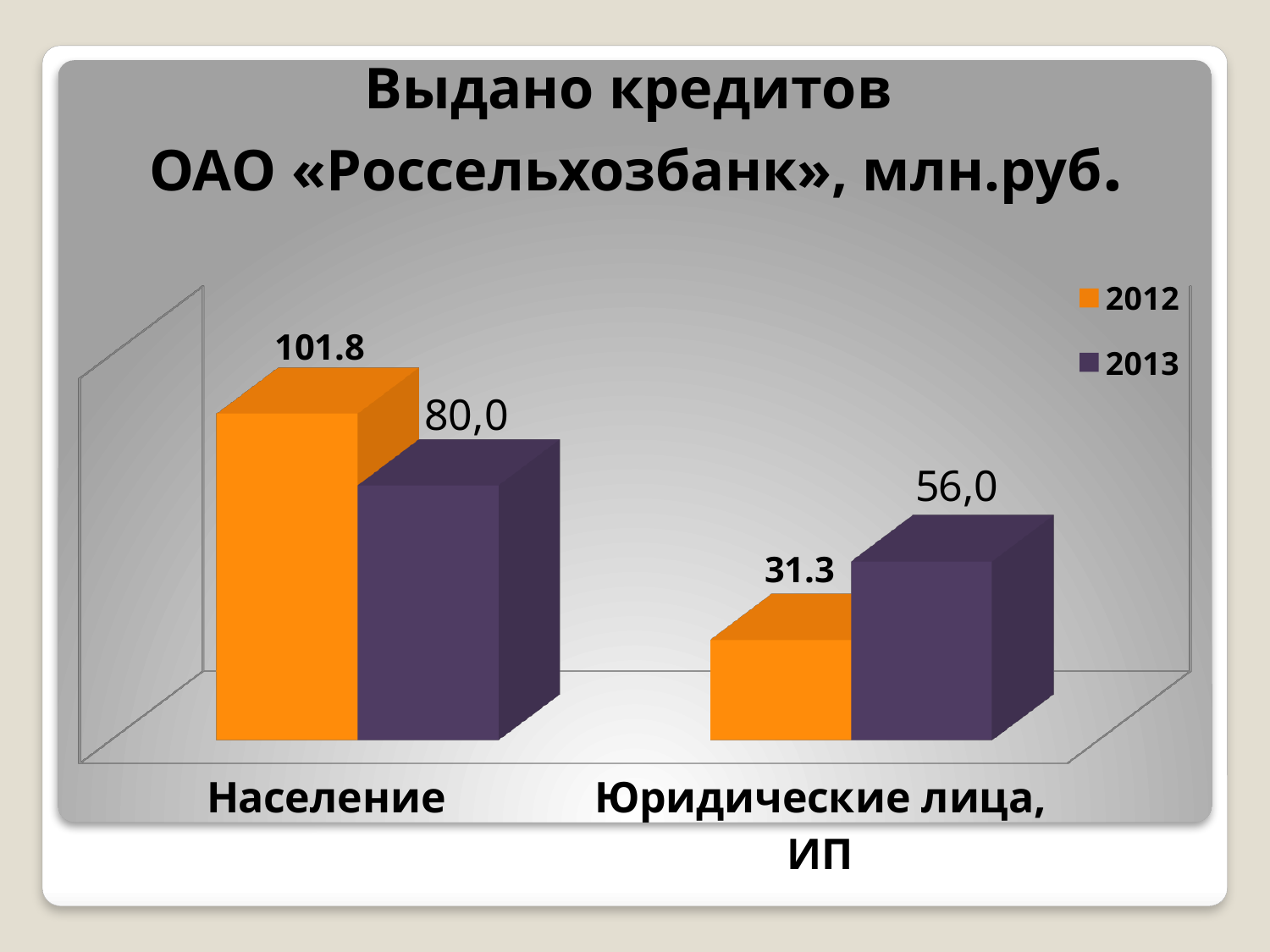
What is the value for Юридические лица, ИП in 2012? 31.3 What is the difference between the 2013 and 2012 values for Юридические лица, ИП? 24.7 Which category has the lowest value in 2013? Юридические лица, ИП Which is larger for Юридические лица, ИП: the 2012 value or the 2013 value? 2013 Which category has the highest value in 2012? Население What is the value for Население in 2013? 80,0 How many series does the legend list? 2 What kind of chart is shown on the slide? Bar chart What is the value for Население in 2012? 101.8 What is the difference between the 2012 and 2013 values for Население? 21.8 How many categories are shown on the x axis? 2 What is the value for Юридические лица, ИП in 2013? 56,0